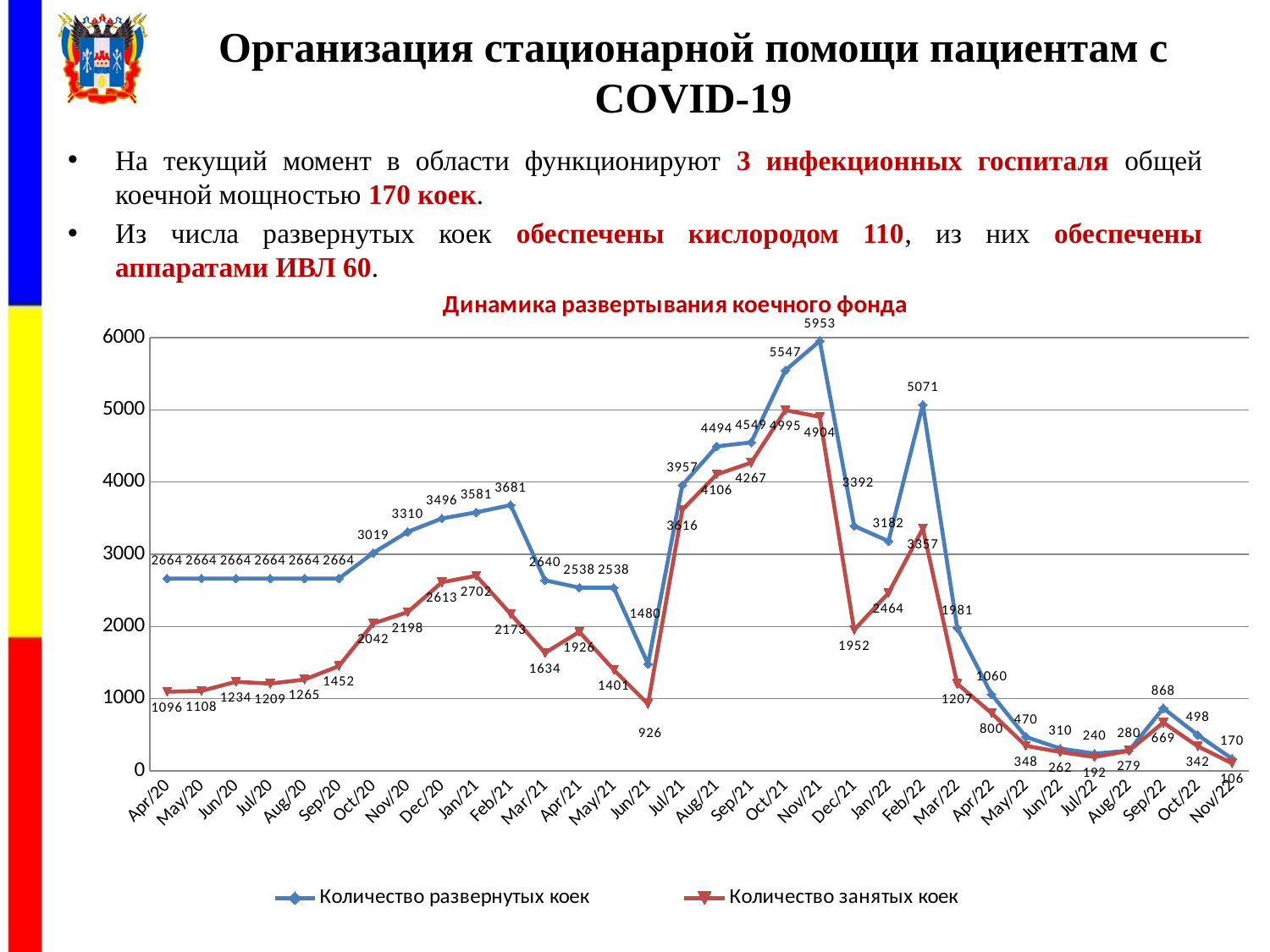
What is the difference between "Количество развернутых коек" and "Количество занятых коек" in Nov/21? 1049 In Feb/22, which series has the larger value: "Количество развернутых коек" or "Количество занятых коек"? Количество развернутых коек How many series does the legend of the chart list? 2 In which month does "Количество развернутых коек" have its lowest value? Nov/22 In which month does "Количество развернутых коек" reach its highest value? Nov/21 How many months are plotted along the x axis of the chart? 32 What is the value of "Количество развернутых коек" for Nov/21? 5953 What is the value of "Количество занятых коек" for Jun/21? 926 What is the value of "Количество развернутых коек" for Feb/22? 5071 What kind of chart is shown under the title "Динамика развертывания коечного фонда"? line chart Does "Количество развернутых коек" rise or fall from Mar/22 to Jul/22? fall What is the value of "Количество занятых коек" for Nov/22? 106